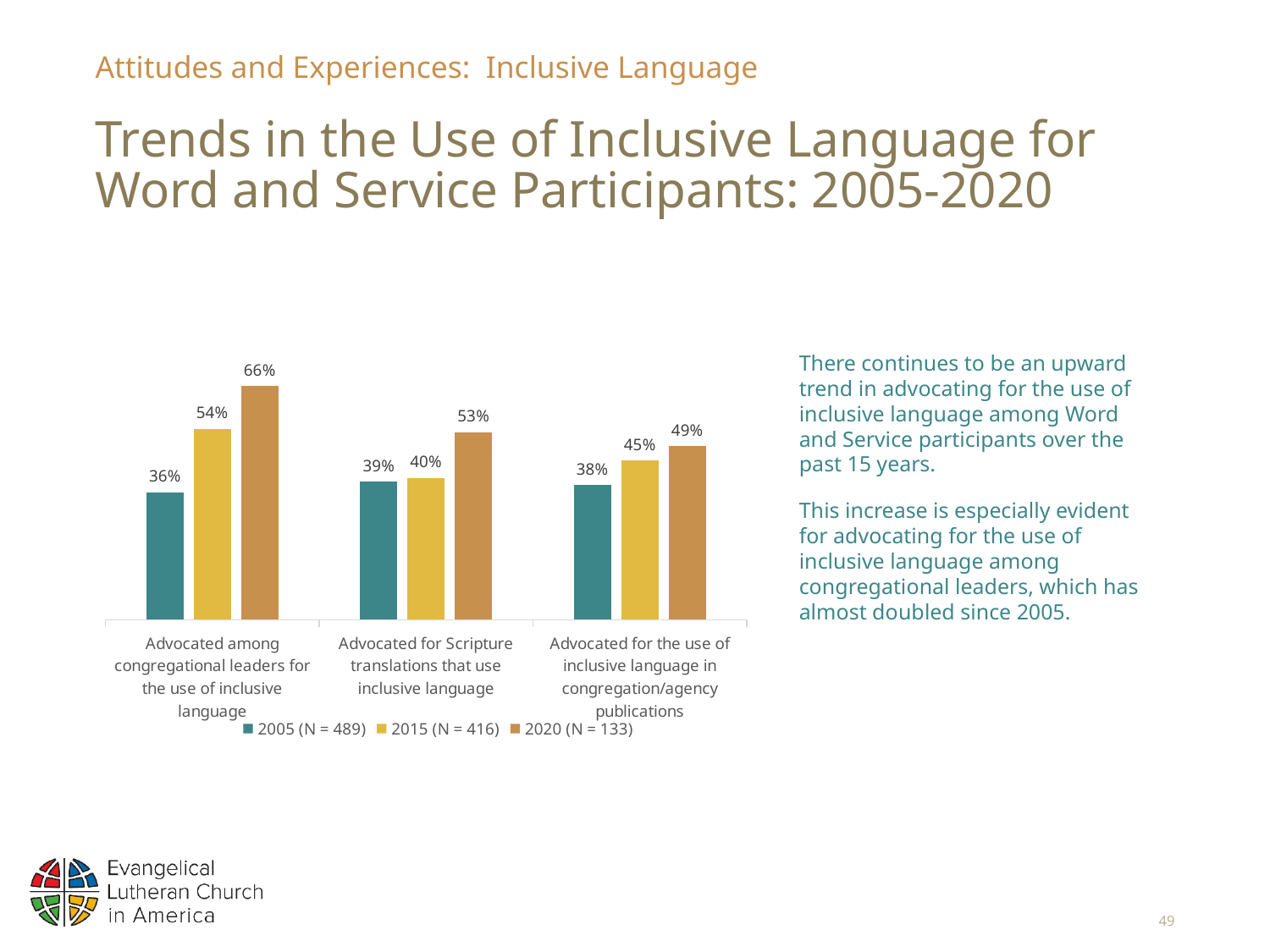
What is the 2005 value for 'Advocated for Scripture translations that use inclusive language'? 39% What is the 2015 value for 'Advocated for the use of inclusive language in congregation/agency publications'? 45% What is the 2020 value for 'Advocated among congregational leaders for the use of inclusive language'? 66% Do the values for 'Advocated for the use of inclusive language in congregation/agency publications' rise or fall from 2005 to 2020? Rise How many series does the legend list? 3 What kind of chart is shown on the slide? Bar chart How many categories are shown on the x axis? 3 What is the difference between the 2020 and 2005 values for 'Advocated among congregational leaders for the use of inclusive language'? 30 percentage points Which category has the highest 2020 value? Advocated among congregational leaders for the use of inclusive language What is the sample size (N) shown in the legend for the 2020 series? 133 Which category has the lowest 2005 value? Advocated among congregational leaders for the use of inclusive language Which is larger: the 2015 value for 'Advocated for Scripture translations that use inclusive language' or the 2015 value for 'Advocated for the use of inclusive language in congregation/agency publications'? Advocated for the use of inclusive language in congregation/agency publications